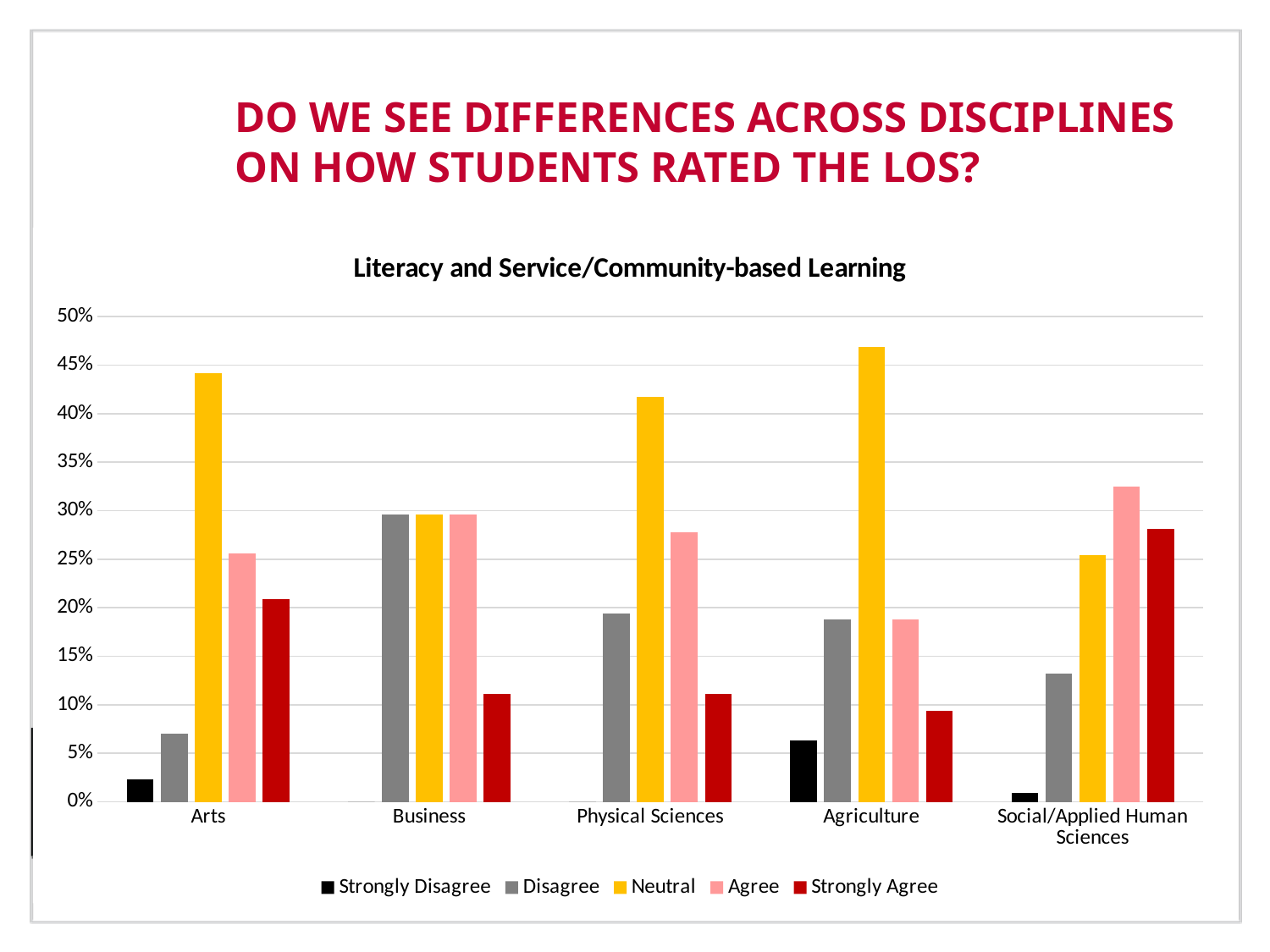
Is the Neutral value for Arts greater or less than 40%? greater How many disciplines are shown on the x axis? 5 Is the Agree value for Social/Applied Human Sciences greater or less than 30%? greater Which discipline has the highest Neutral value? Agriculture Within Social/Applied Human Sciences, which response category has the highest value? Agree What kind of chart is shown on the slide? Bar chart Is the Agree value for Physical Sciences greater or less than 25%? greater Which is larger, the Strongly Agree value for Arts or for Business? Arts Which is larger, the Strongly Disagree value for Agriculture or for Arts? Agriculture How many series does the legend list? 5 Which discipline has the lowest Neutral value? Social/Applied Human Sciences What is the title of the chart? Literacy and Service/Community-based Learning